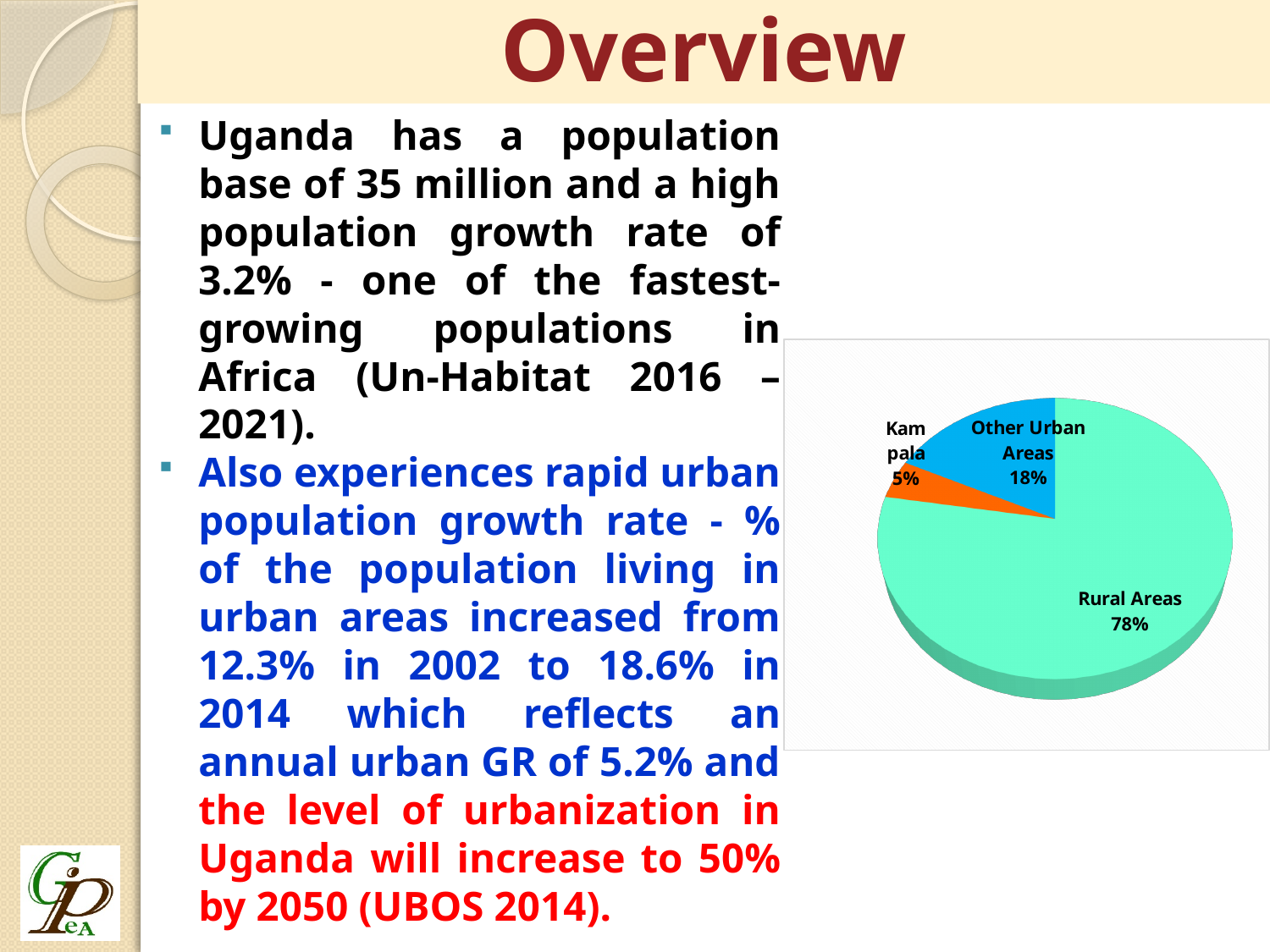
Which is larger, the share for Other Urban Areas or the share for Kampala? Other Urban Areas What is the difference in percentage points between Other Urban Areas and Kampala? 13 What kind of chart is shown on the slide? pie chart How many slices does the pie chart have? 3 What share of the pie does Other Urban Areas have? 18% What is the difference in percentage points between Rural Areas and Other Urban Areas? 60 What colour is the Kampala slice? orange What share of the pie does Rural Areas have? 78% Which slice of the pie is the smallest? Kampala What share of the pie does Kampala have? 5% What colour is the Rural Areas slice? light green Which slice of the pie is the largest? Rural Areas